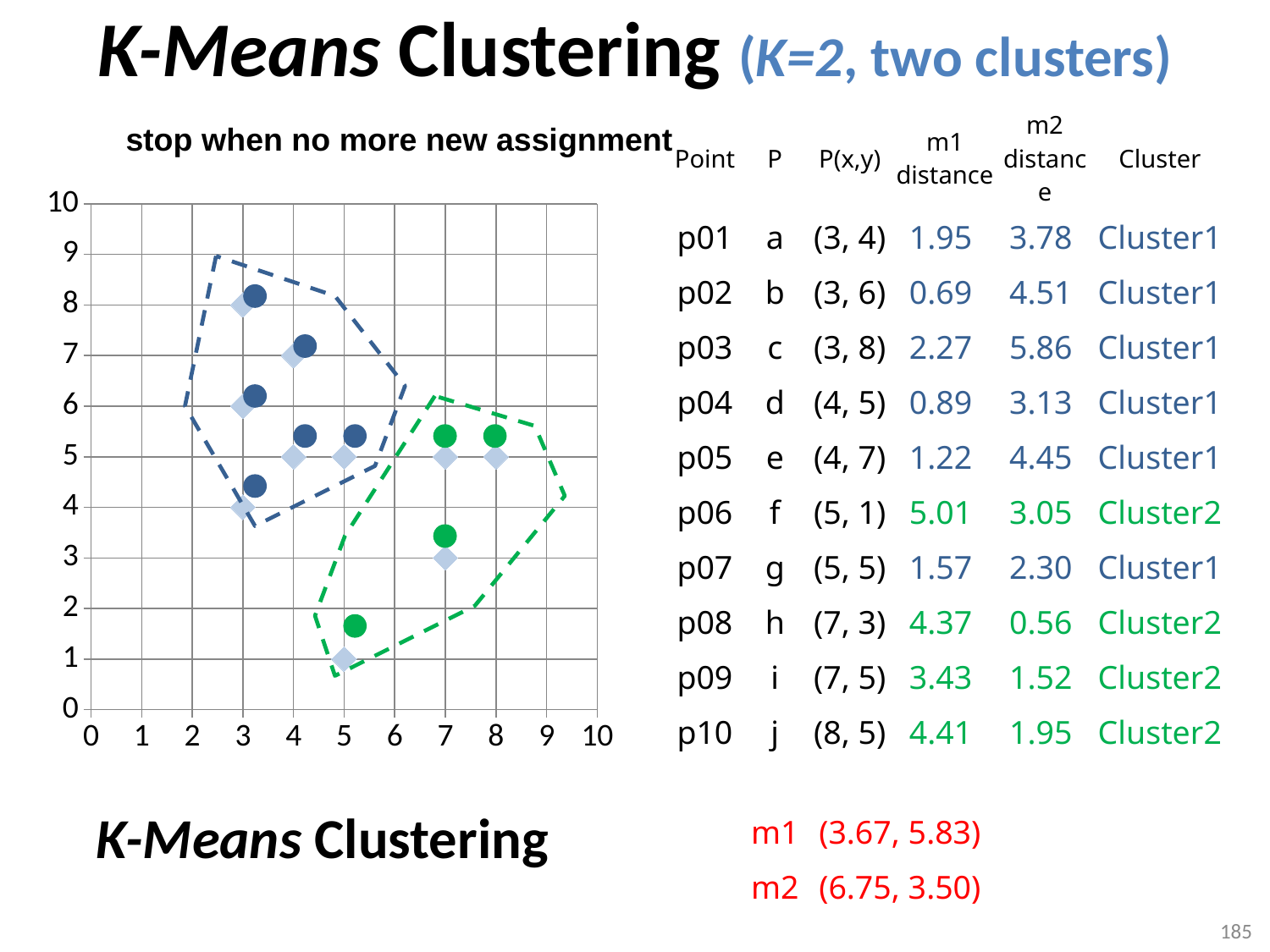
How many dashed cluster outlines are drawn on the scatter chart? 2 Which point has the largest x value in the scatter chart? j What are the coordinates of point c in the scatter chart? (3, 8) What is the maximum value shown on the y axis of the scatter chart? 10 What are the coordinates of centroid m1 listed on the slide? (3.67, 5.83) Which point has the lowest y value in the scatter chart? f What kind of chart is shown on the left of the slide? scatter chart How many data points are plotted in the scatter chart? 10 What is the difference in y value between point c (3, 8) and point f (5, 1)? 7 What are the coordinates of point f in the scatter chart? (5, 1) Which point has a larger x value, point h or point b? h Which point has the highest y value in the scatter chart? c